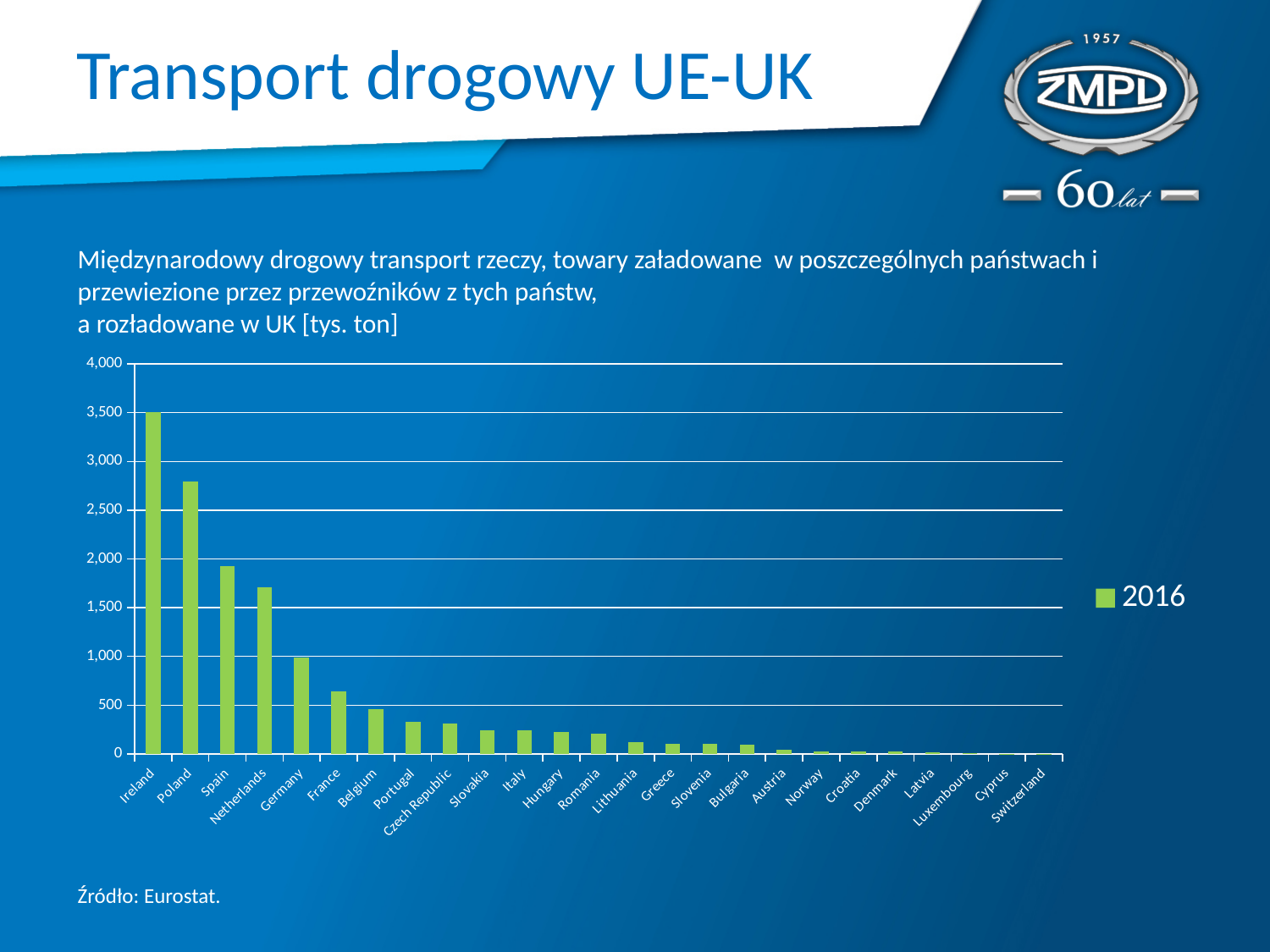
What year does the legend entry show? 2016 Is the value for Germany greater or less than 1,500? less How many series does the legend list? 1 Is the value for Poland greater or less than 2,500? greater Which country has the highest value in the chart? Ireland Is the value for France greater or less than 500? greater Do the values rise or fall moving from left to right along the x axis? fall What kind of chart is shown on the slide? bar chart Which has the larger value, Spain or Netherlands? Spain How many countries are shown on the x axis of the chart? 25 Which has the larger value, Poland or Spain? Poland